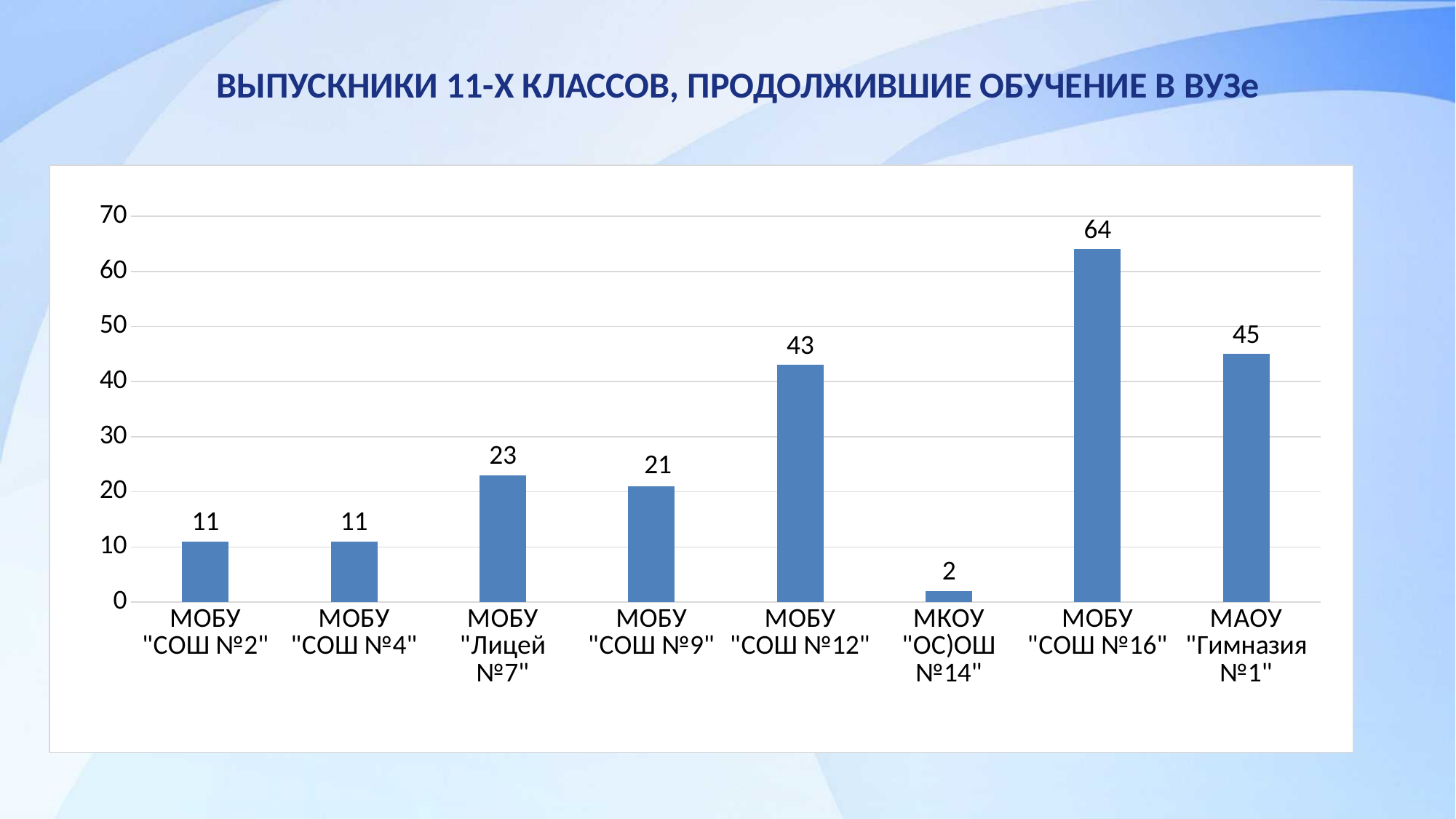
What is the title of the slide? ВЫПУСКНИКИ 11-Х КЛАССОВ, ПРОДОЛЖИВШИЕ ОБУЧЕНИЕ В ВУЗе Is the value for МОБУ "СОШ №16" greater or less than 60? greater What is the value for МОБУ "Лицей №7"? 23 Which school has the highest value? МОБУ "СОШ №16" What is the value for МАОУ "Гимназия №1"? 45 What is the difference between the values for МОБУ "СОШ №16" and МАОУ "Гимназия №1"? 19 Which is larger, the value for МОБУ "СОШ №12" or the value for МАОУ "Гимназия №1"? МАОУ "Гимназия №1" What kind of chart is shown on the slide? bar chart What is the value for МОБУ "СОШ №12"? 43 How many schools are shown on the chart? 8 Which school has the lowest value? МКОУ "ОС)ОШ №14" What is the difference between the values for МОБУ "Лицей №7" and МОБУ "СОШ №9"? 2